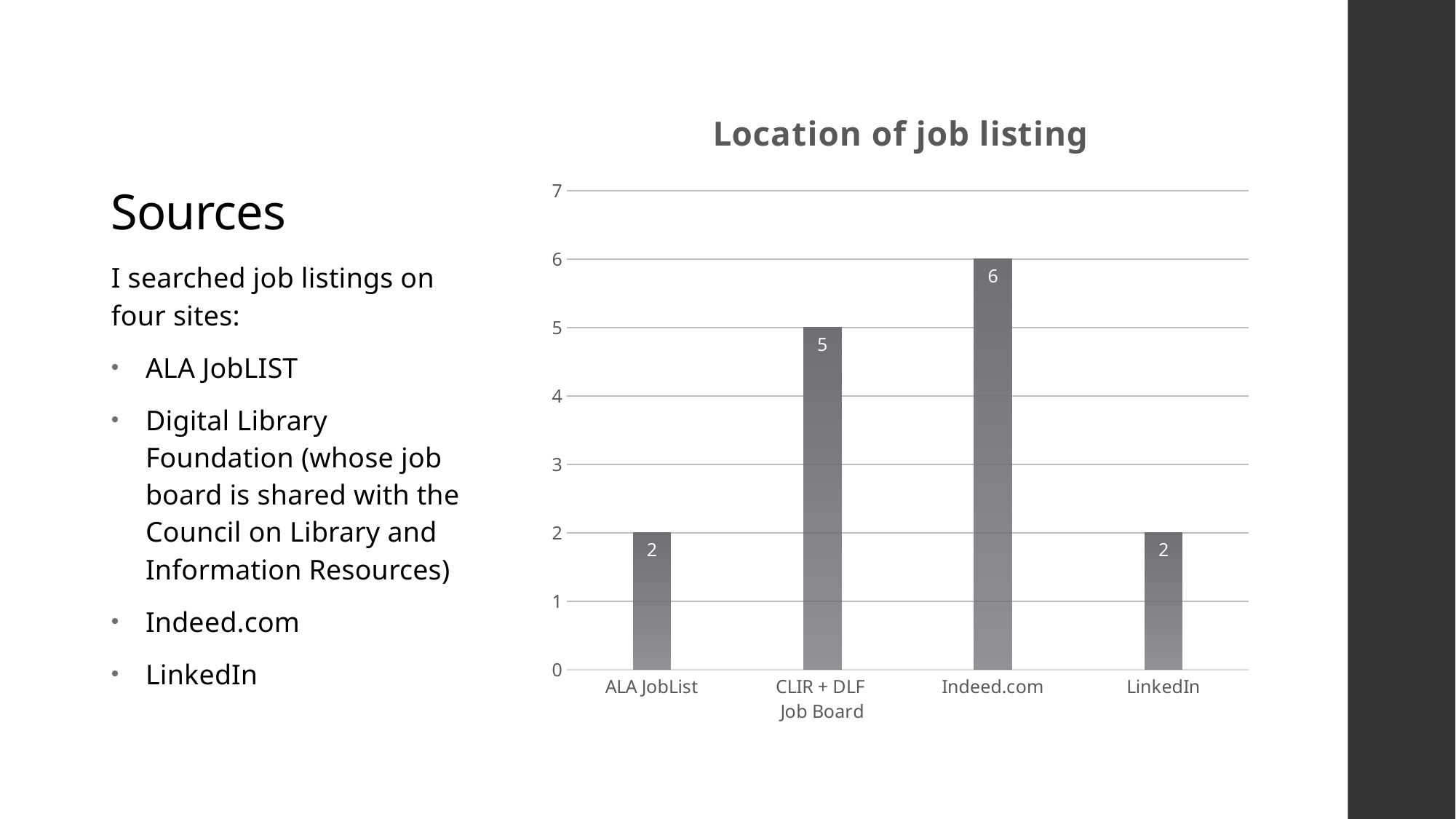
Which is larger, the value for CLIR + DLF Job Board or the value for LinkedIn? CLIR + DLF Job Board What is the difference between the values for Indeed.com and CLIR + DLF Job Board? 1 What is the value for Indeed.com in the Location of job listing chart? 6 What is the value for ALA JobList? 2 What kind of chart is shown on the slide? bar chart How many categories are shown on the x axis? 4 What is the highest value shown on the y axis? 7 What is the value for CLIR + DLF Job Board? 5 What is the title of the chart? Location of job listing What is the difference between the values for Indeed.com and LinkedIn? 4 Is the value for CLIR + DLF Job Board greater or less than 3? greater Which category has the highest value? Indeed.com